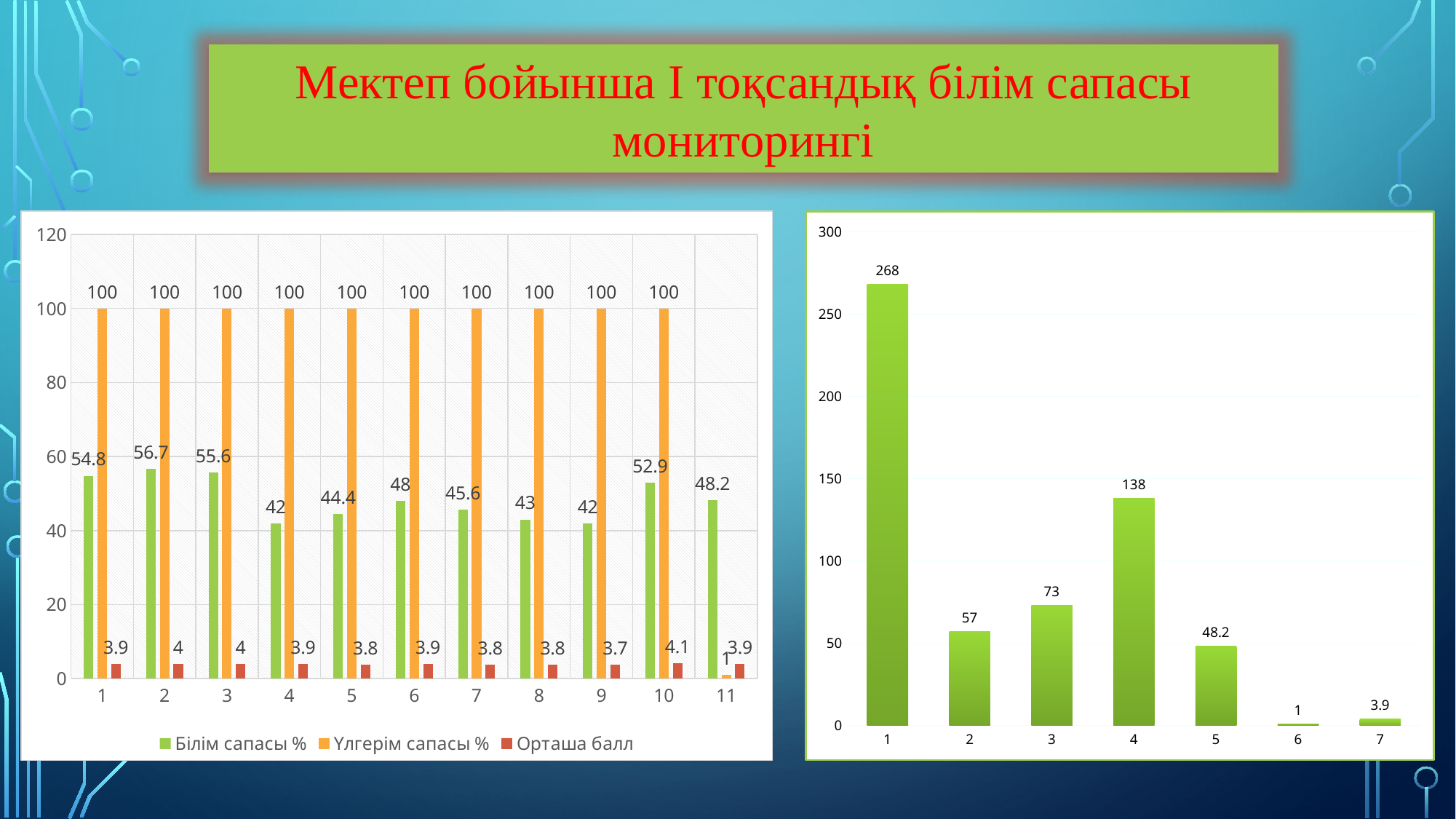
In the left chart, how many series does the legend list? 3 In the left chart, which category has the lowest Орташа балл value? 9 In the right chart, what is the difference between the values for category 1 and category 4? 130 In the left chart, what is the value of Орташа балл for category 10? 4.1 In the left chart, which category has the highest Білім сапасы % value? 2 What type of chart is the right chart? Bar chart In the left chart, what is the value of Білім сапасы % for category 2? 56.7 In the right chart, which category has the lowest value? 6 In the right chart, which category has the highest value? 1 In the right chart, what is the value for category 4? 138 In the left chart, what is the difference between the Білім сапасы % values for category 1 and category 4? 12.8 In the left chart, how many categories are shown on the x axis? 11